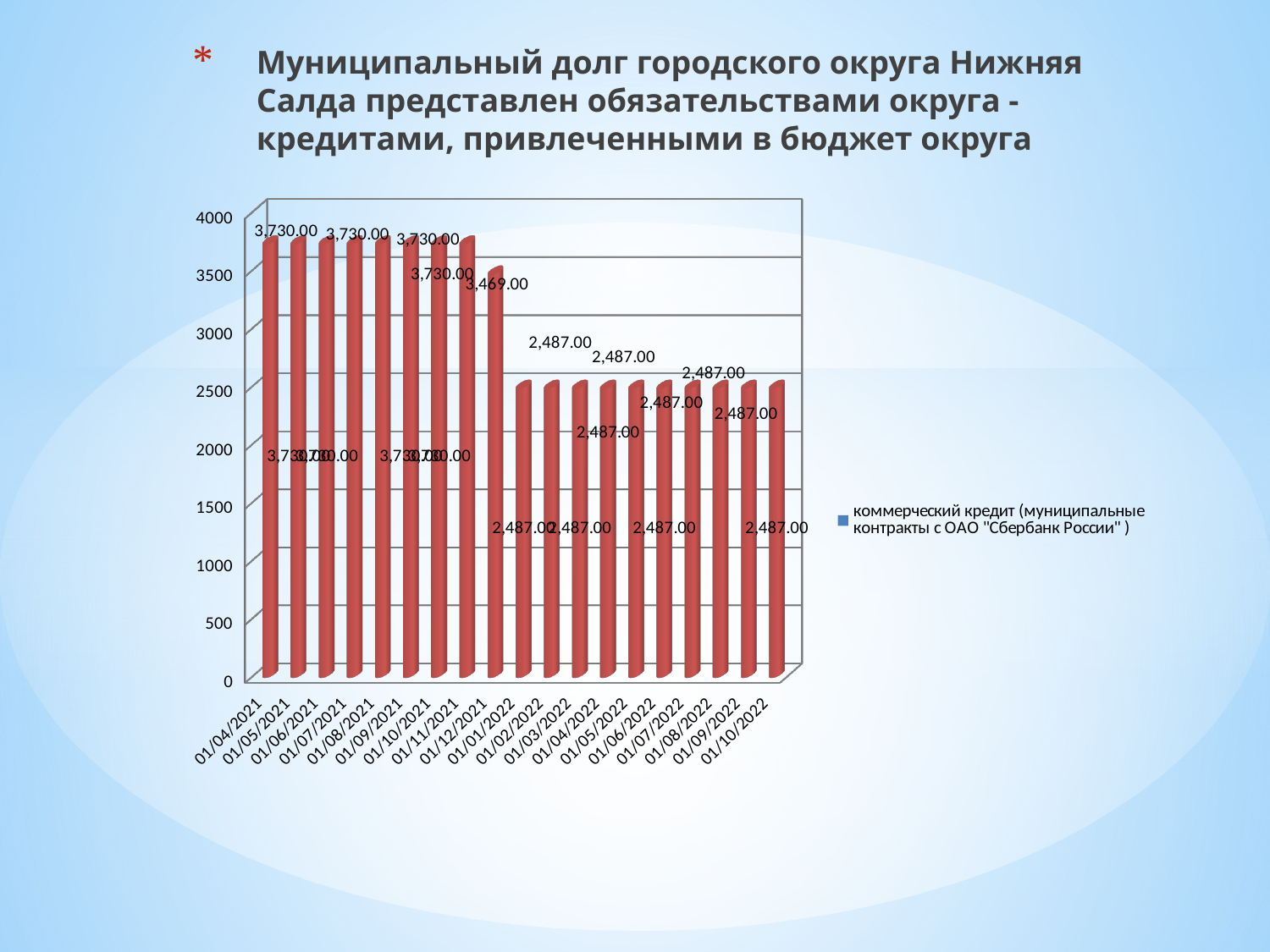
Is the value for 01/01/2022 greater or less than 3000? less What is the value for 01/12/2021? 3,469.00 What is the difference between the value for 01/04/2021 and the value for 01/01/2022? 1,243.00 Which is larger, the value for 01/11/2021 or the value for 01/01/2022? 01/11/2021 What is the value for 01/10/2022? 2,487.00 What is the lowest value shown in the chart? 2,487.00 What is the value for 01/04/2021? 3,730.00 What is the highest value shown in the chart? 3,730.00 How many dates are shown on the x axis? 19 How many series does the legend list? 1 What kind of chart is shown on the slide? bar chart What is the difference between the value for 01/11/2021 and the value for 01/12/2021? 261.00